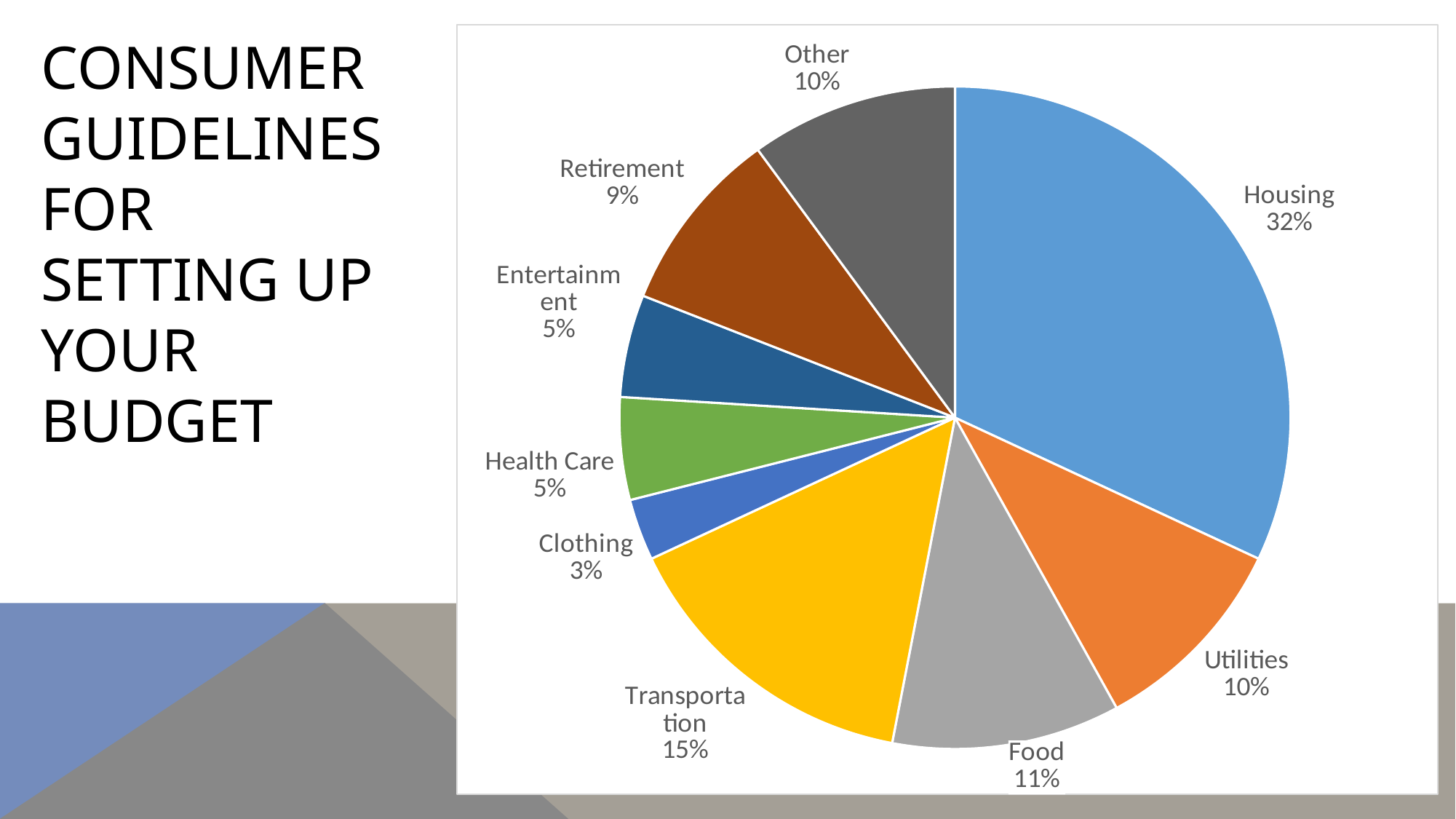
What colour is the Transportation slice? yellow What type of chart is shown on the slide? pie chart What percentage of the budget is allocated to Transportation? 15% How many categories are shown in the pie chart? 9 What is the difference in percentage points between Housing and Transportation? 17 Which is larger, the share for Food or the share for Retirement? Food Which category has the largest share of the budget? Housing Which category has the smallest share of the budget? Clothing What percentage of the budget is allocated to Retirement? 9% What percentage of the budget is allocated to Housing? 32% What percentage of the budget is allocated to Clothing? 3% What is the difference in percentage points between Food and Health Care? 6